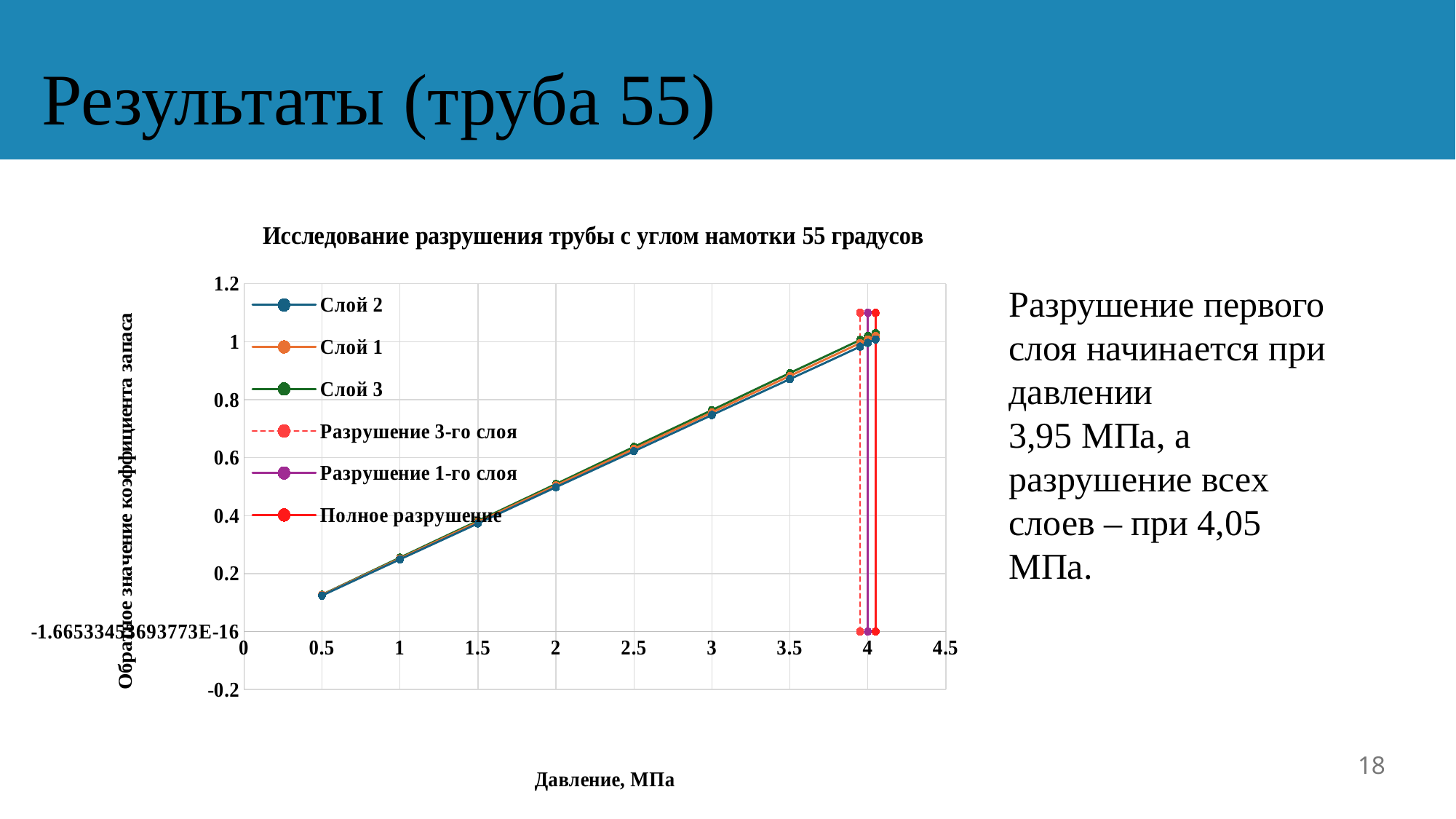
Is the value for Слой 2 at 1 МПа greater or less than 0.4? less How many data points are plotted for the series Слой 2? 10 What is the title of the chart? Исследование разрушения трубы с углом намотки 55 градусов What kind of chart is shown on the slide? line chart Is the value for Слой 1 at 0.5 МПа greater or less than 0.2? less Is the value for Слой 3 at 2.5 МПа greater or less than 0.8? less What is the label of the x axis of the chart? Давление, МПа How many series does the chart legend list? 6 Do the values for Слой 1 rise or fall as pressure increases along the x axis? rise